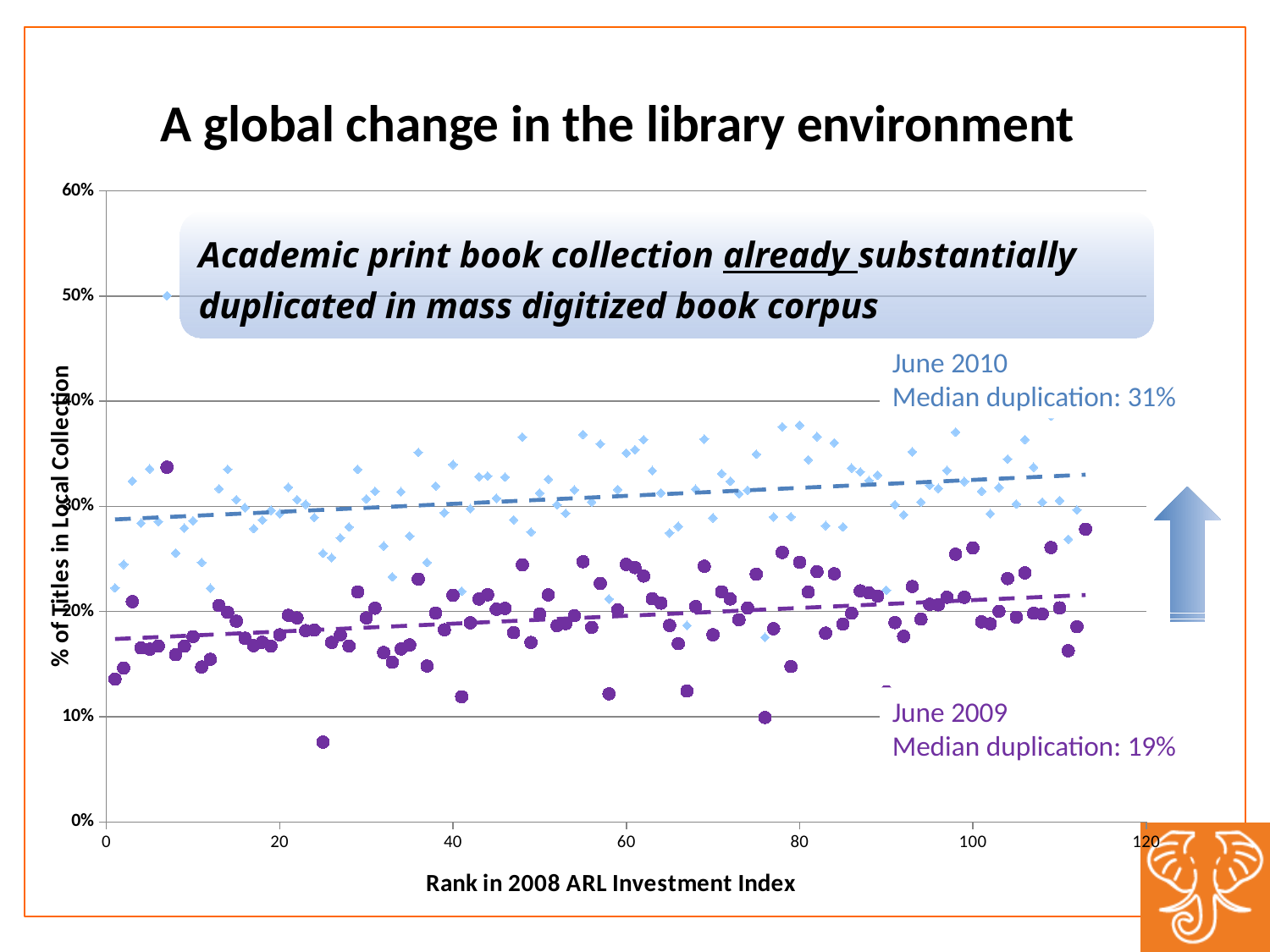
How many data series are plotted on the chart? 2 Which series has the higher median duplication, June 2010 or June 2009? June 2010 Does the dashed trend line for the June 2010 series rise or fall as rank increases along the x axis? Rises What is the label of the y axis? % of Titles in Local Collection What is the median duplication for June 2009 according to the chart annotation? 19% What kind of chart is shown on the slide? Scatter chart Is the June 2009 median duplication greater or less than 20%? less What is the maximum value shown on the y axis? 60% What is the label of the x axis? Rank in 2008 ARL Investment Index What is the median duplication for June 2010 according to the chart annotation? 31% What is the difference between the June 2010 and June 2009 median duplication values? 12 percentage points Is the June 2010 median duplication greater or less than 30%? greater